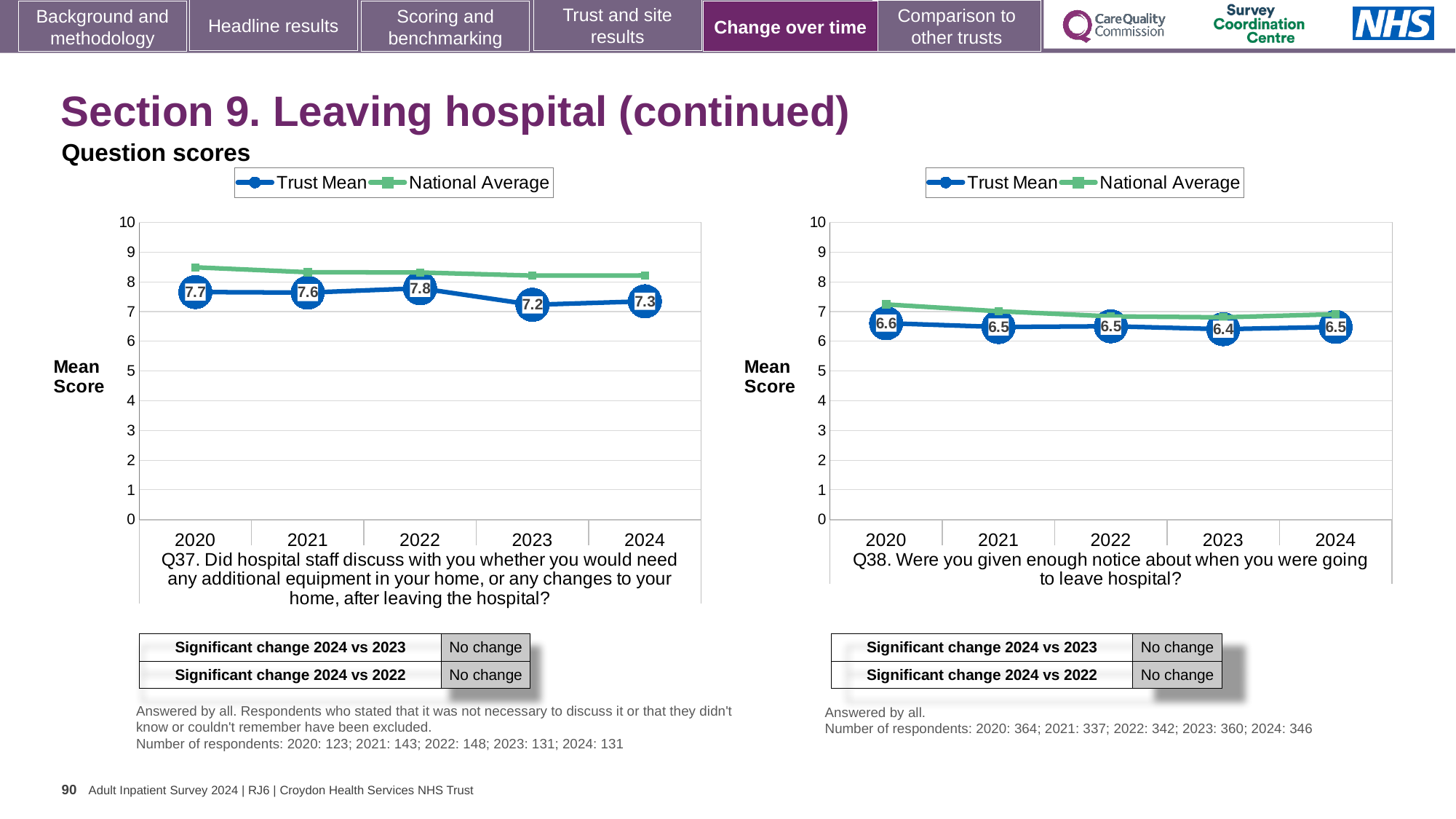
How many series does the legend of the Q38 chart on the right list? 2 In the Q37 chart on the left, what is the difference between the Trust Mean scores for 2022 and 2023? 0.6 In the Q37 chart on the left, which year has the lowest Trust Mean score? 2023 In the Q38 chart on the right, which year has the lowest Trust Mean score? 2023 What kind of chart is the Q37 chart on the left? Line chart In the Q37 chart on the left, what is the Trust Mean score for 2022? 7.8 In the Q38 chart on the right, what is the Trust Mean score for 2023? 6.4 In the Q37 chart on the left, what is the Trust Mean score for 2023? 7.2 In the Q38 chart on the right, is the National Average for 2020 greater or less than 7? greater In the Q38 chart on the right, what is the Trust Mean score for 2020? 6.6 In the Q37 chart on the left, is the National Average for 2020 greater or less than 8? greater In the Q37 chart on the left, which year has the highest Trust Mean score? 2022